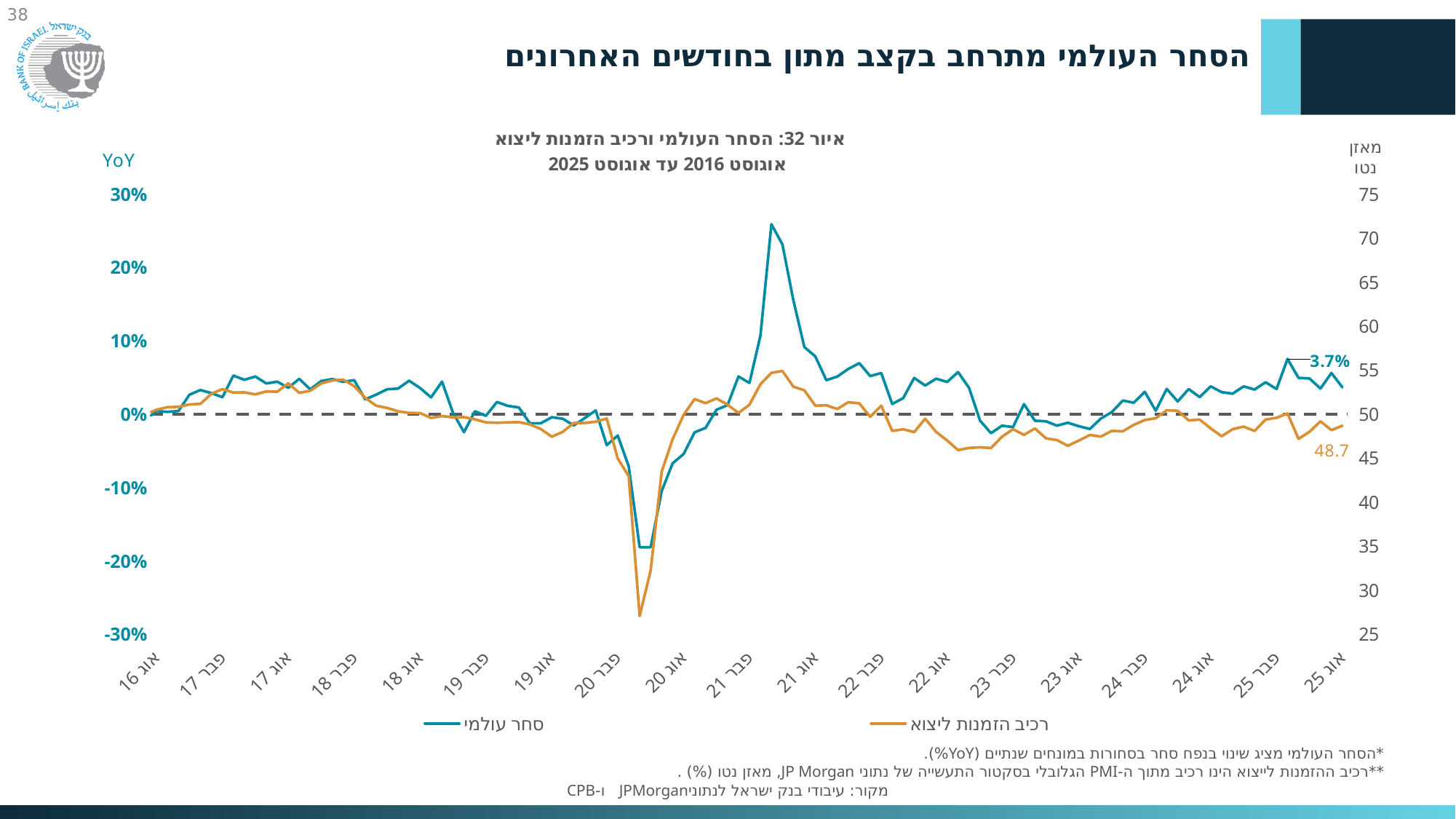
What is the highest tick value shown on the right vertical axis? 75 Which series is drawn in orange? רכיב הזמנות ליצוא Is the latest value of the export orders component (רכיב הזמנות ליצוא) greater or less than 50? less What is the lowest tick value shown on the left vertical axis? -30% What is the label of the left vertical axis? YoY Is the peak of the world trade (סחר עולמי) series around 2021 greater or less than 20%? greater Is the lowest point of the world trade (סחר עולמי) series in 2020 greater or less than -10%? less What is the latest labelled value of the world trade (סחר עולמי) series? 3.7% What kind of chart is shown on the slide? Line chart How many series does the legend list? 2 What is the latest labelled value of the export orders component (רכיב הזמנות ליצוא) series? 48.7